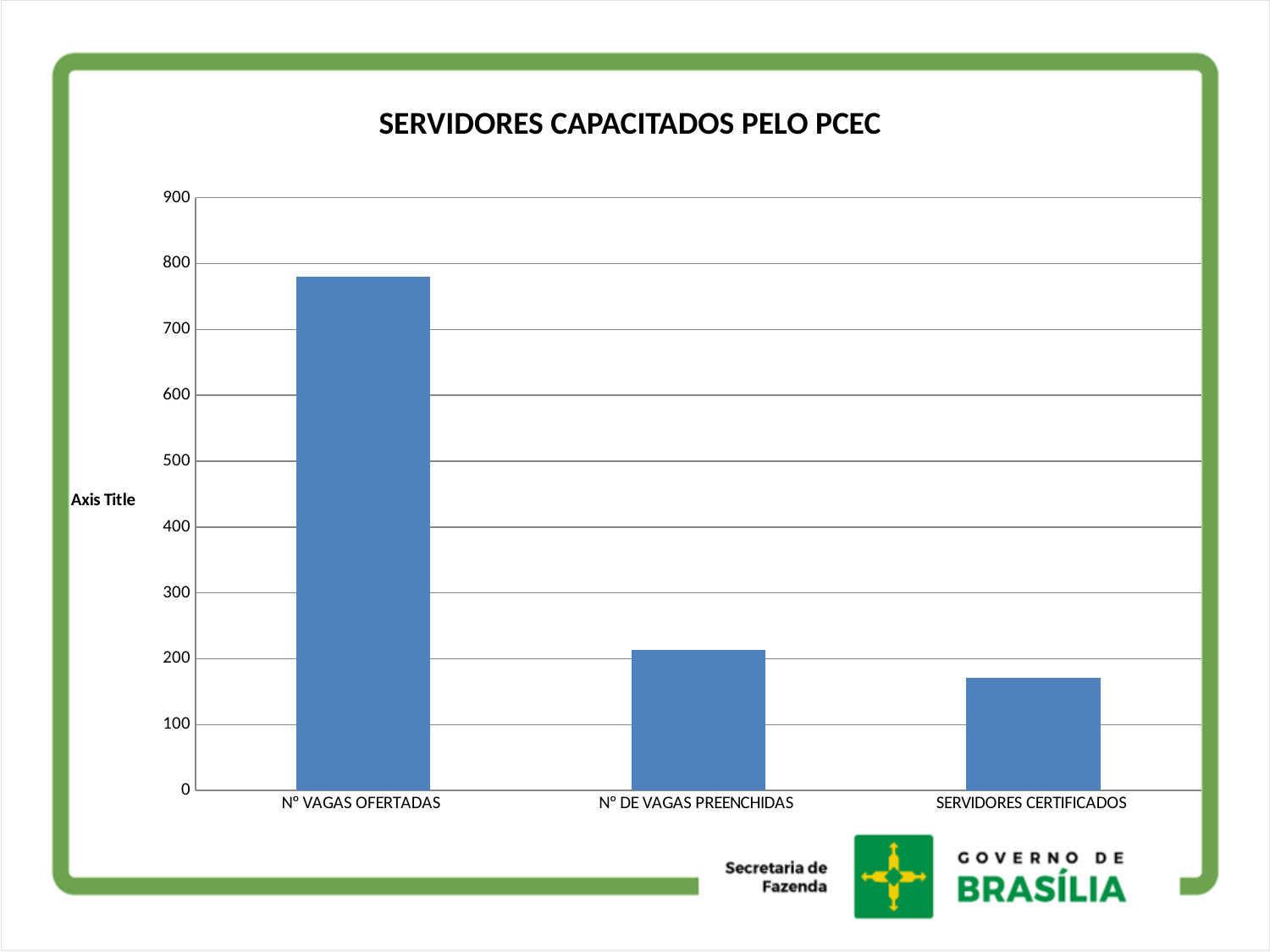
Is the value for Nº VAGAS OFERTADAS greater or less than 800? less Is the value for Nº VAGAS OFERTADAS greater or less than 700? greater Which is larger, the value for Nº DE VAGAS PREENCHIDAS or the value for SERVIDORES CERTIFICADOS? Nº DE VAGAS PREENCHIDAS Is the value for Nº DE VAGAS PREENCHIDAS greater or less than 200? greater What is the label shown on the vertical axis of the chart? Axis Title What is the title of the chart? SERVIDORES CAPACITADOS PELO PCEC What kind of chart is shown on the slide? bar chart How many categories are shown on the x axis of the chart? 3 Which category has the lowest bar? SERVIDORES CERTIFICADOS Do the bar values rise or fall from left to right along the x axis? fall Which category has the highest bar? Nº VAGAS OFERTADAS